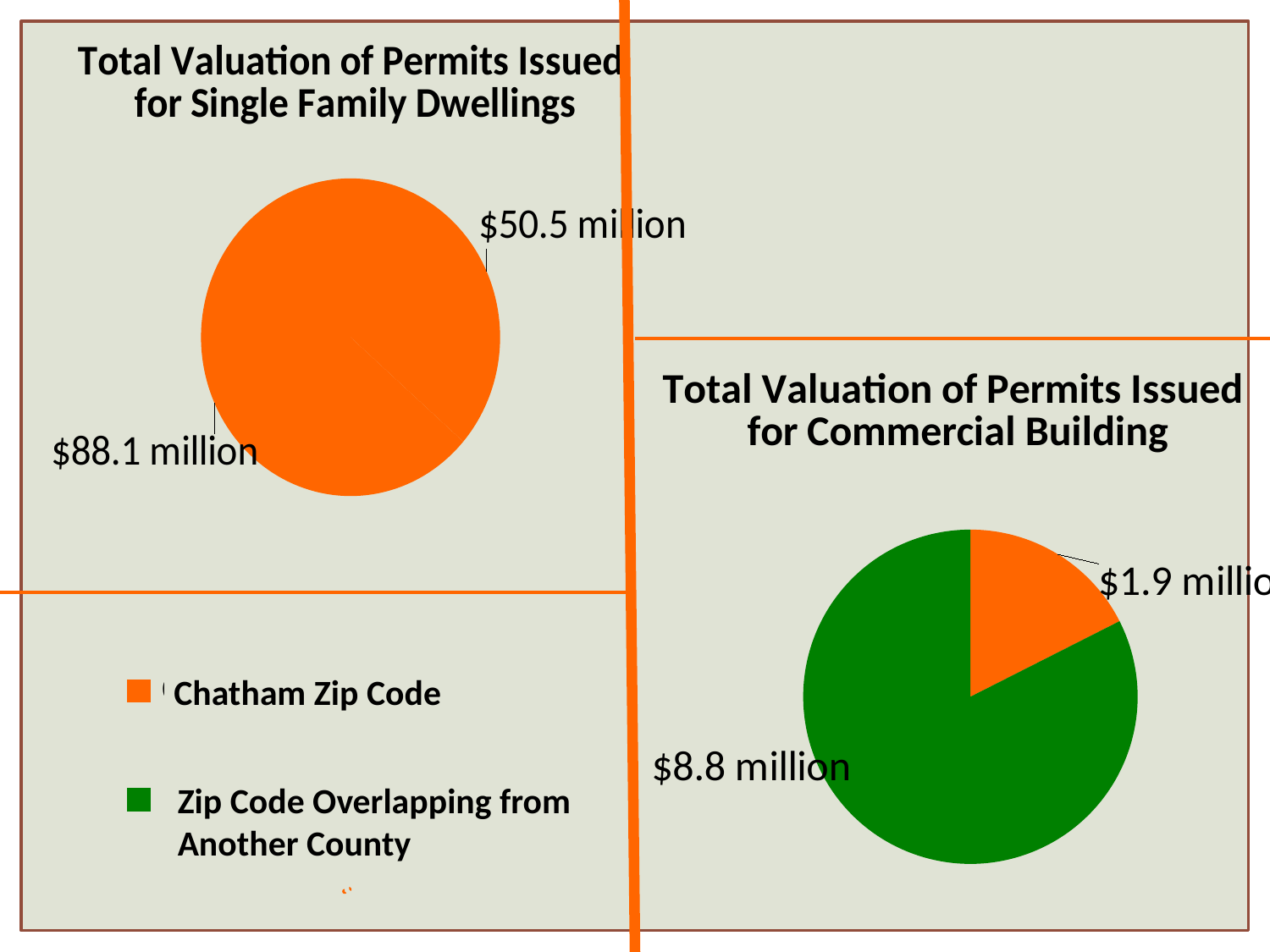
What kind of chart is used for 'Total Valuation of Permits Issued for Commercial Building'? pie chart In the 'Total Valuation of Permits Issued for Single Family Dwellings' chart, what is the difference between the two labeled values? $37.6 million How many entries does the legend list? 2 In the 'Total Valuation of Permits Issued for Commercial Building' chart, what is the value for Zip Code Overlapping from Another County? $8.8 million In the 'Total Valuation of Permits Issued for Commercial Building' chart, which category has the largest slice? Zip Code Overlapping from Another County In the 'Total Valuation of Permits Issued for Commercial Building' chart, what is the difference between the Zip Code Overlapping from Another County value and the Chatham Zip Code value? $6.9 million In the 'Total Valuation of Permits Issued for Commercial Building' chart, which category has the smallest slice? Chatham Zip Code How many slices does the 'Total Valuation of Permits Issued for Commercial Building' pie chart have? 2 In the 'Total Valuation of Permits Issued for Commercial Building' chart, what is the value for Chatham Zip Code? $1.9 million In the 'Total Valuation of Permits Issued for Commercial Building' chart, what is the total of the two slices? $10.6 million In the 'Total Valuation of Permits Issued for Single Family Dwellings' chart, what is the larger of the two labeled values? $88.1 million Which colour represents Chatham Zip Code in the legend? orange